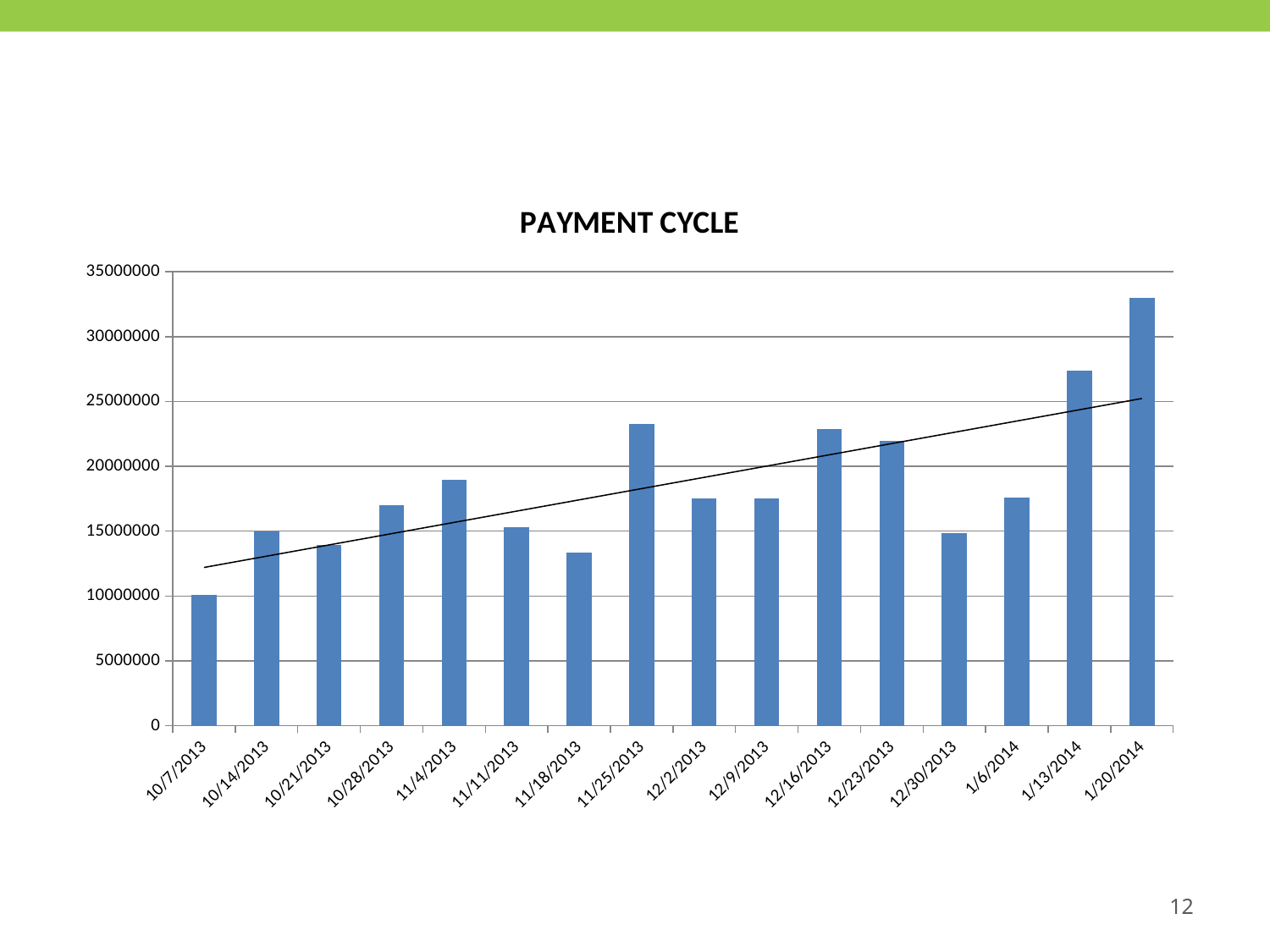
Does the trend line drawn across the chart rise or fall from left to right? rise Is the value for 1/20/2014 greater or less than 30000000? greater How many dates are plotted along the x axis of the chart? 16 What kind of chart is shown on the slide? bar chart Is the value for 11/25/2013 greater or less than 20000000? greater Which date has the lowest bar in the chart? 10/7/2013 Which date has the highest bar in the chart? 1/20/2014 Is the value for 12/30/2013 greater or less than 20000000? less Which is larger, the value for 1/13/2014 or the value for 12/16/2013? 1/13/2014 Which is larger, the value for 11/18/2013 or the value for 11/4/2013? 11/4/2013 What is the title of the chart? PAYMENT CYCLE